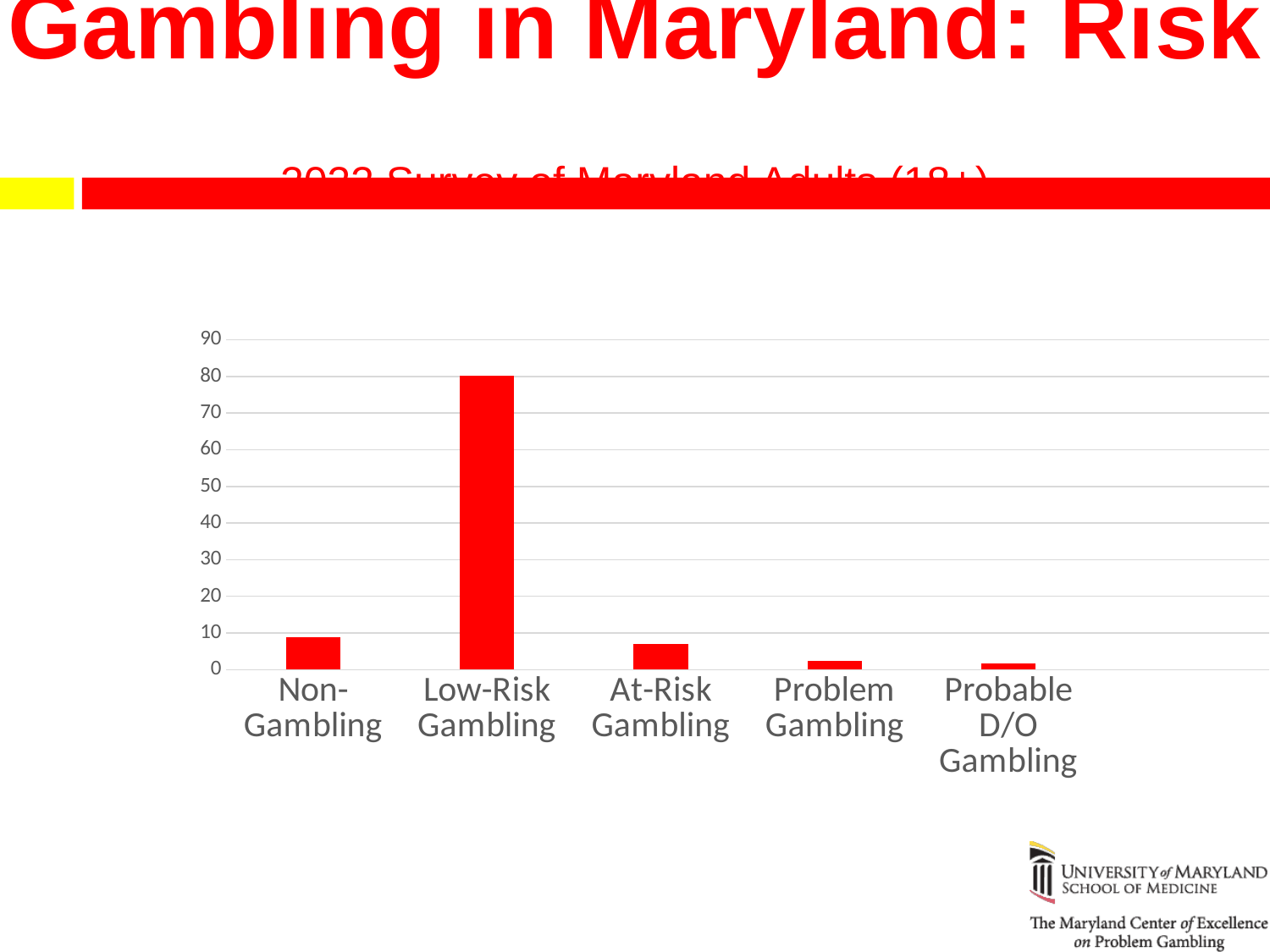
How many categories are shown on the x axis of the chart? 5 Is the value for Non-Gambling greater or less than 20? less Is the value for Problem Gambling greater or less than 10? less What colour are the bars in the chart? red Which is larger, the value for Low-Risk Gambling or the value for Problem Gambling? Low-Risk Gambling Which category has the highest bar in the chart? Low-Risk Gambling Is the value for Low-Risk Gambling greater or less than 50? greater Which is larger, the value for Low-Risk Gambling or the value for Non-Gambling? Low-Risk Gambling What kind of chart is shown on the slide? bar chart